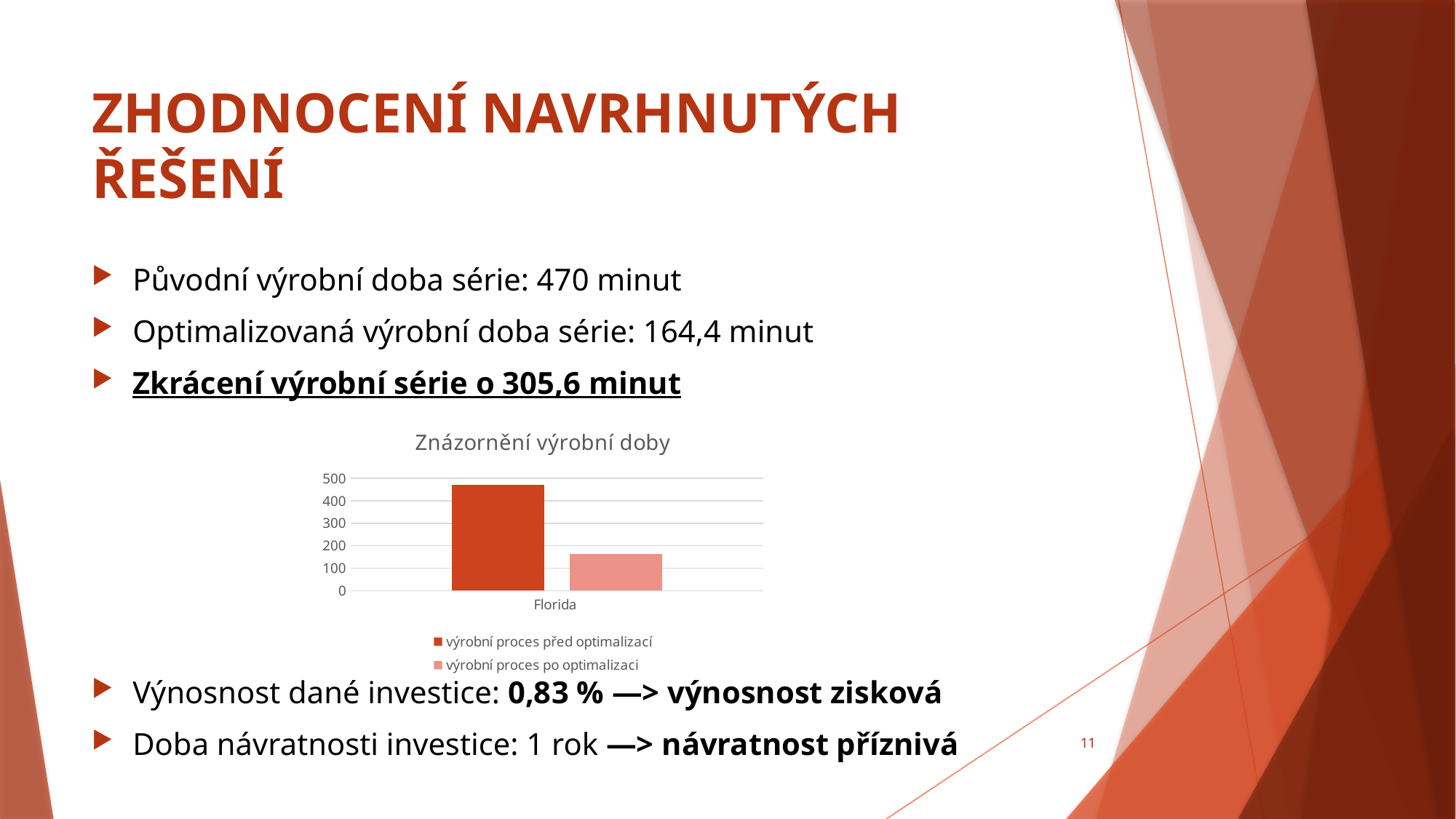
What kind of chart is shown on the slide? bar chart Which is larger: the bar for 'výrobní proces před optimalizací' or the bar for 'výrobní proces po optimalizaci'? výrobní proces před optimalizací How many series does the chart legend list? 2 Is the bar for 'výrobní proces po optimalizaci' greater or less than 100? greater Is the bar for 'výrobní proces po optimalizaci' greater or less than 200? less What is the title of the chart? Znázornění výrobní doby Which series has the lower bar in the chart? výrobní proces po optimalizaci Is the bar for 'výrobní proces před optimalizací' greater or less than 400? greater How many categories are shown on the x axis of the chart? 1 What is the highest value shown on the y axis of the chart? 500 What is the category label on the x axis of the chart? Florida Which series has the higher bar in the chart? výrobní proces před optimalizací